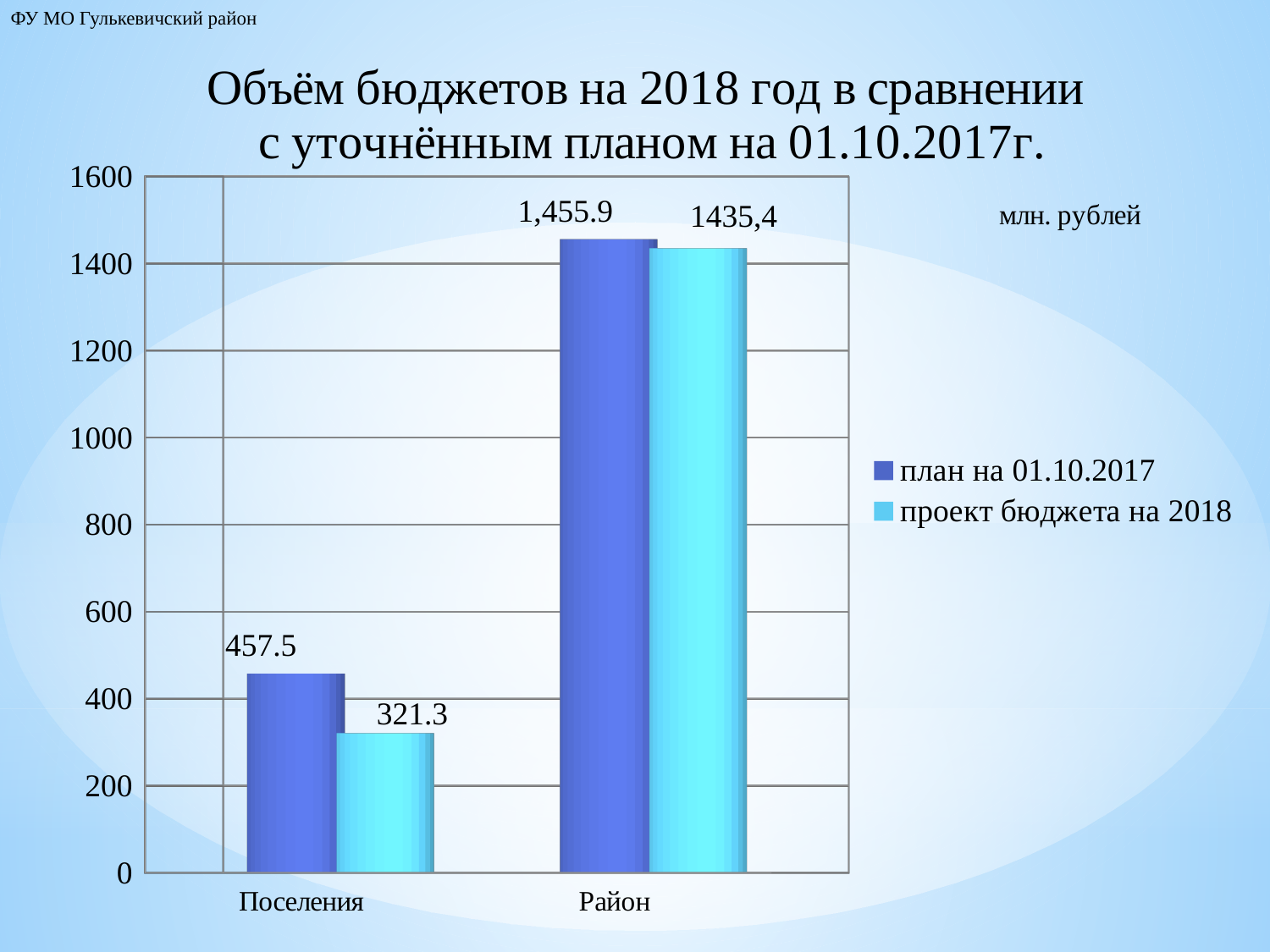
For Поселения, which is larger: план на 01.10.2017 or проект бюджета на 2018? план на 01.10.2017 Is the value for Район in the проект бюджета на 2018 series greater or less than 1400? greater What is the value for Район in the план на 01.10.2017 series? 1,455.9 How many categories are shown on the x axis? 2 Which category has the highest value in the план на 01.10.2017 series? Район How many series does the legend list? 2 What is the value for Поселения in the проект бюджета на 2018 series? 321.3 What kind of chart is shown on the slide? bar chart What is the value for Поселения in the план на 01.10.2017 series? 457.5 What is the difference between the план на 01.10.2017 and проект бюджета на 2018 values for Поселения? 136.2 Which category has the lowest value in the проект бюджета на 2018 series? Поселения What is the value for Район in the проект бюджета на 2018 series? 1435,4